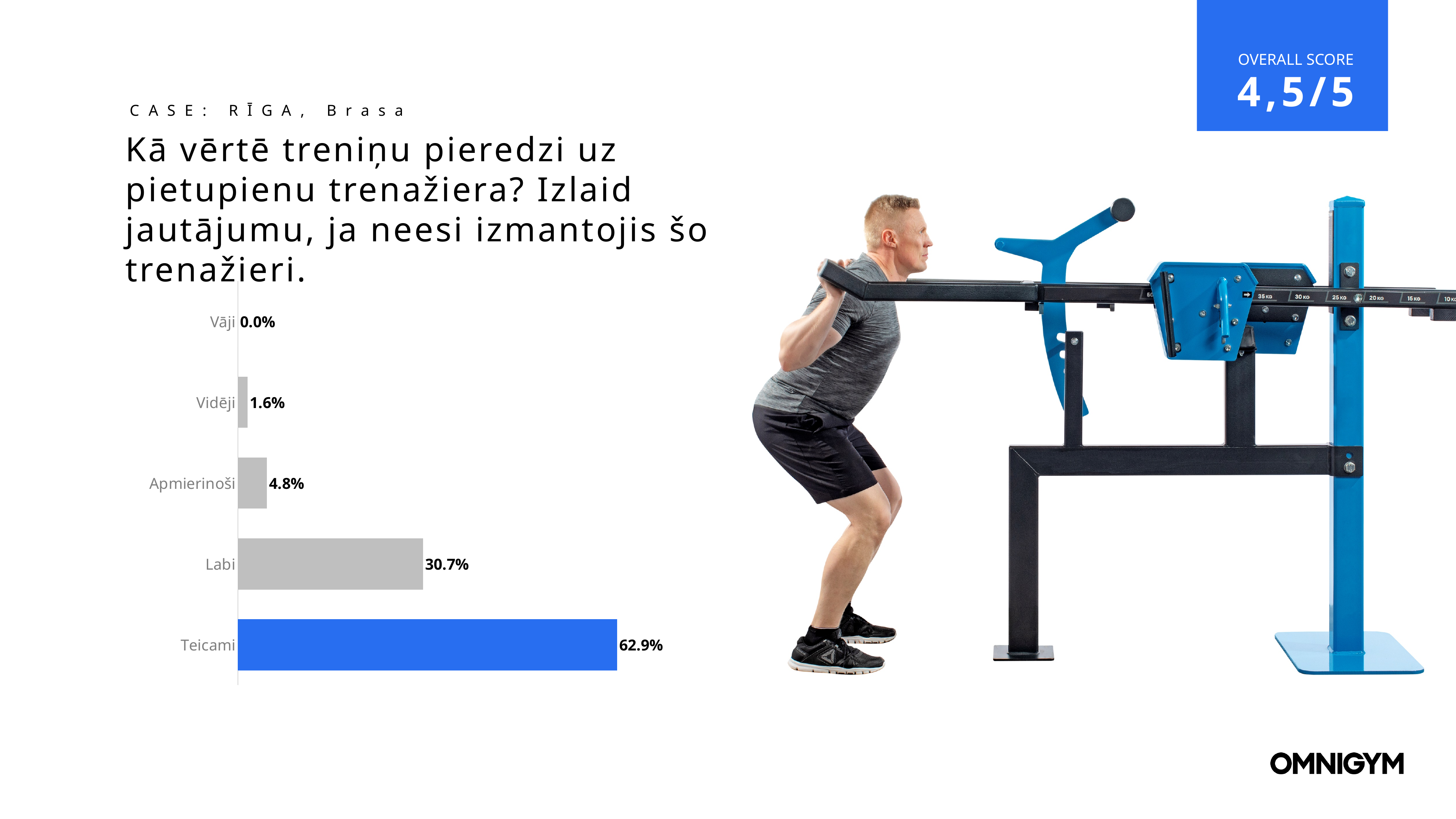
Which is larger, the value for Apmierinoši or the value for Vidēji? Apmierinoši What is the value for Labi? 30.7% Which bar is coloured blue rather than grey? Teicami What kind of chart is shown on the slide? Bar chart What is the value for Apmierinoši? 4.8% What is the value for Teicami? 62.9% What is the value for Vidēji? 1.6% Which category has the lowest value? Vāji Which category has the highest value? Teicami What is the difference between the values for Teicami and Labi? 32.2% What is the value for Vāji? 0.0% How many categories are shown in the chart? 5